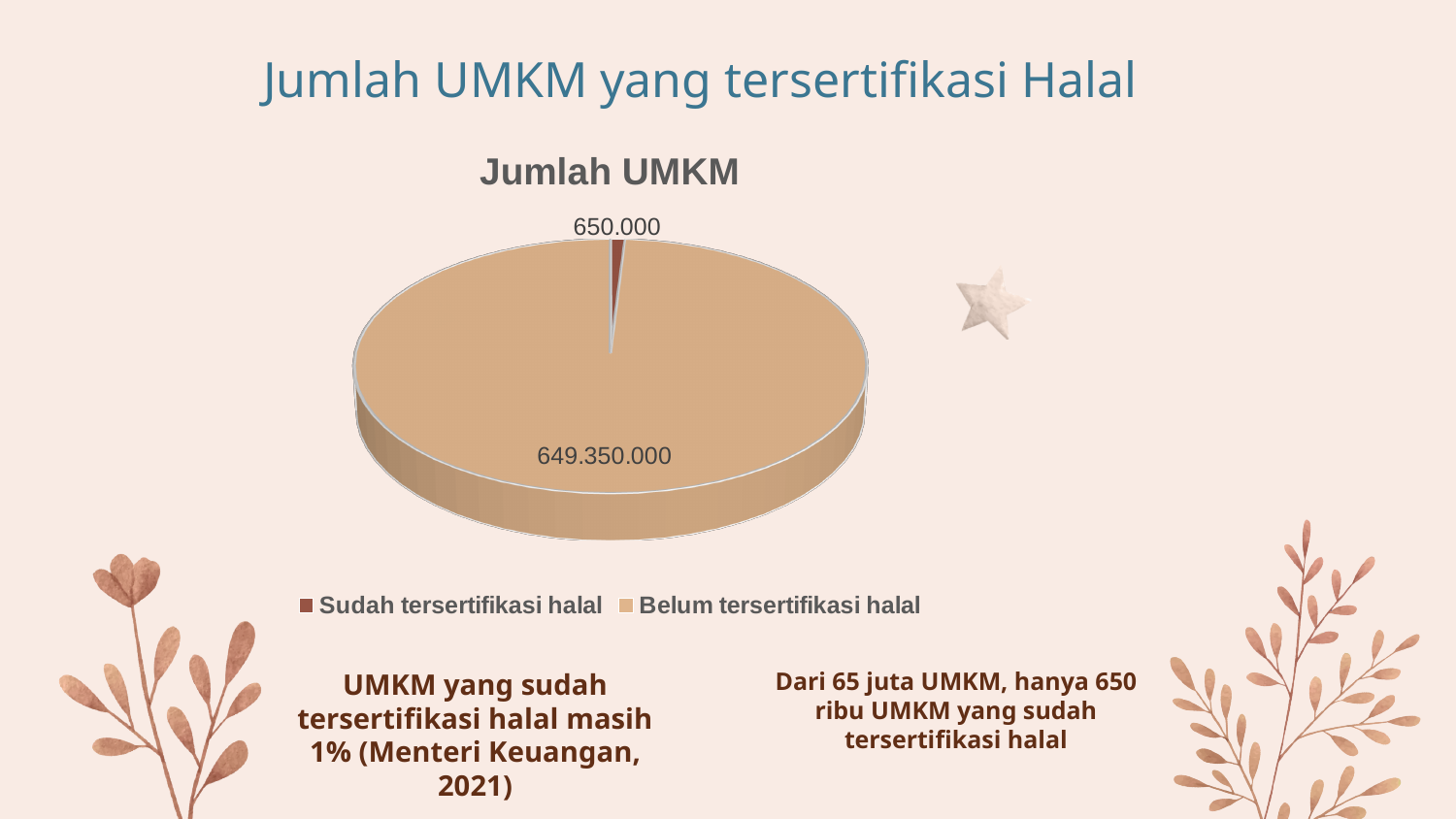
Which legend entry is shown in the dark reddish-brown colour? Sudah tersertifikasi halal What type of chart is shown on the slide? Pie chart What is the difference between the values for "Belum tersertifikasi halal" and "Sudah tersertifikasi halal"? 648.700.000 What is the title of the chart? Jumlah UMKM What is the total of the two values shown in the pie chart? 650.000.000 How many categories does the pie chart have? 2 Which is larger: the value for "Sudah tersertifikasi halal" or "Belum tersertifikasi halal"? Belum tersertifikasi halal Which category has the smallest slice of the pie? Sudah tersertifikasi halal Which category has the largest slice of the pie? Belum tersertifikasi halal How many entries does the legend list? 2 What is the value for "Sudah tersertifikasi halal"? 650.000 What is the value for "Belum tersertifikasi halal"? 649.350.000